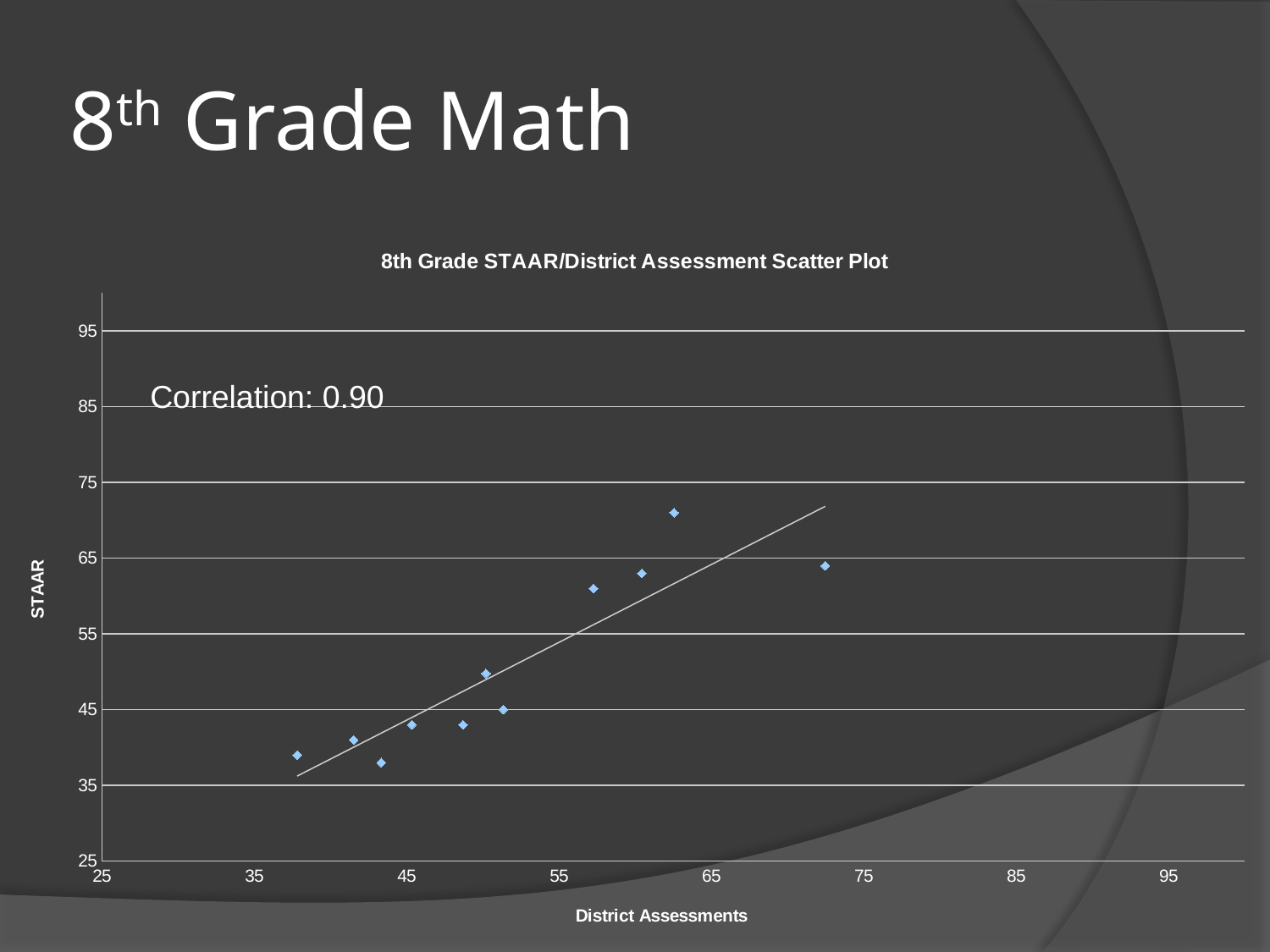
What is the lowest tick value shown on the District Assessments axis? 25 What is the label of the vertical axis? STAAR What kind of chart is shown on the slide? Scatter plot What correlation value is printed on the chart? 0.90 Is the highest District Assessment score plotted greater or less than 65? greater Do STAAR values generally rise or fall as District Assessment scores increase? Rise What is the title of the chart? 8th Grade STAAR/District Assessment Scatter Plot Is the lowest District Assessment score plotted greater or less than 45? less Is the highest STAAR value plotted greater or less than 65? greater How many data points are plotted on the scatter plot? 11 What is the highest tick value shown on the STAAR axis? 95